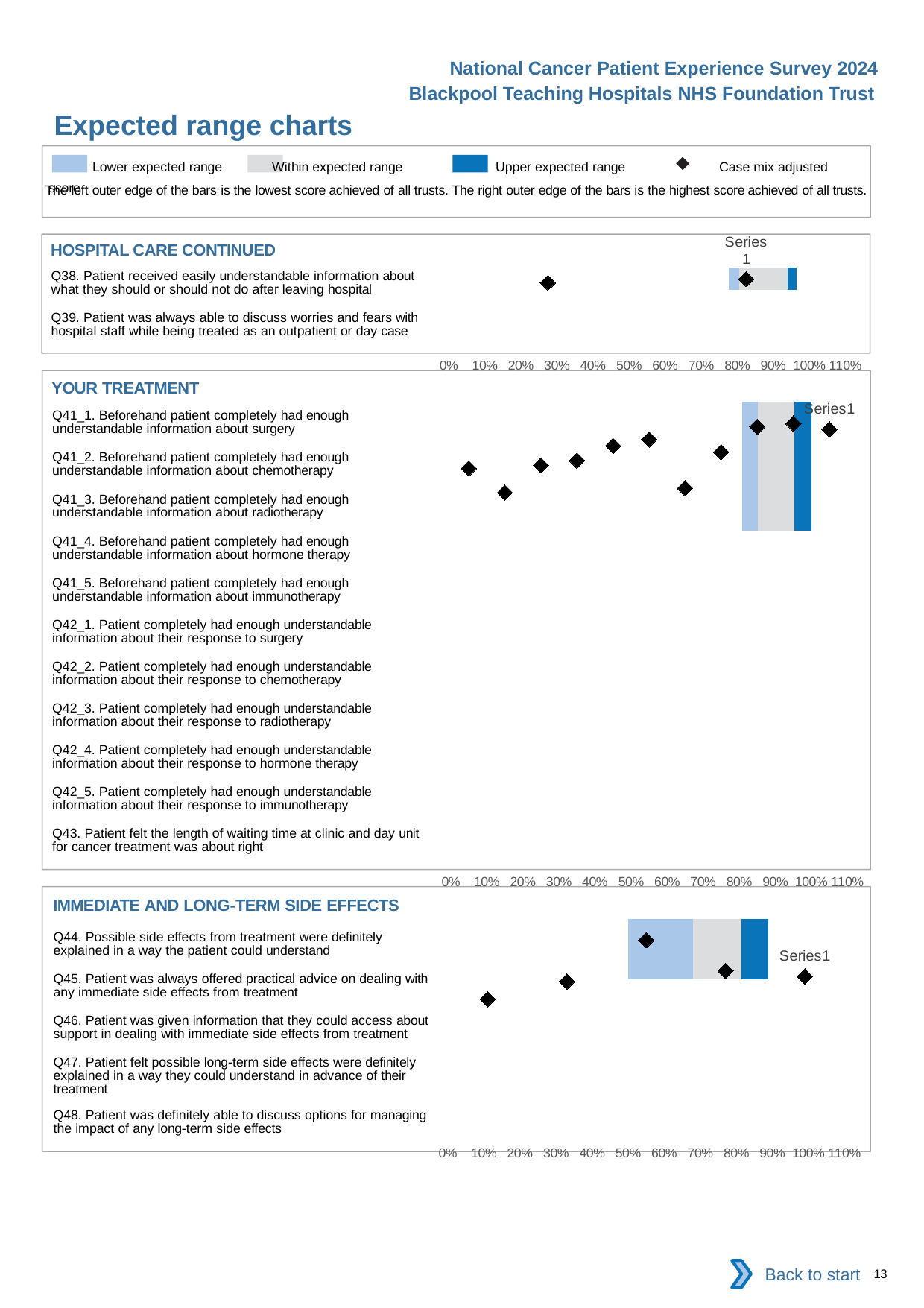
In the YOUR TREATMENT chart, how many questions (categories) are listed? 11 What marker shape is used for the case mix adjusted score in the legend? Diamond In the IMMEDIATE AND LONG-TERM SIDE EFFECTS chart, how many diamond markers are plotted? 5 How many chart sections are shown on the slide? 3 Which chart section on the slide lists the most questions? YOUR TREATMENT What is the highest tick label on the x axis of the YOUR TREATMENT chart? 110% How many entries does the legend at the top of the slide list? 4